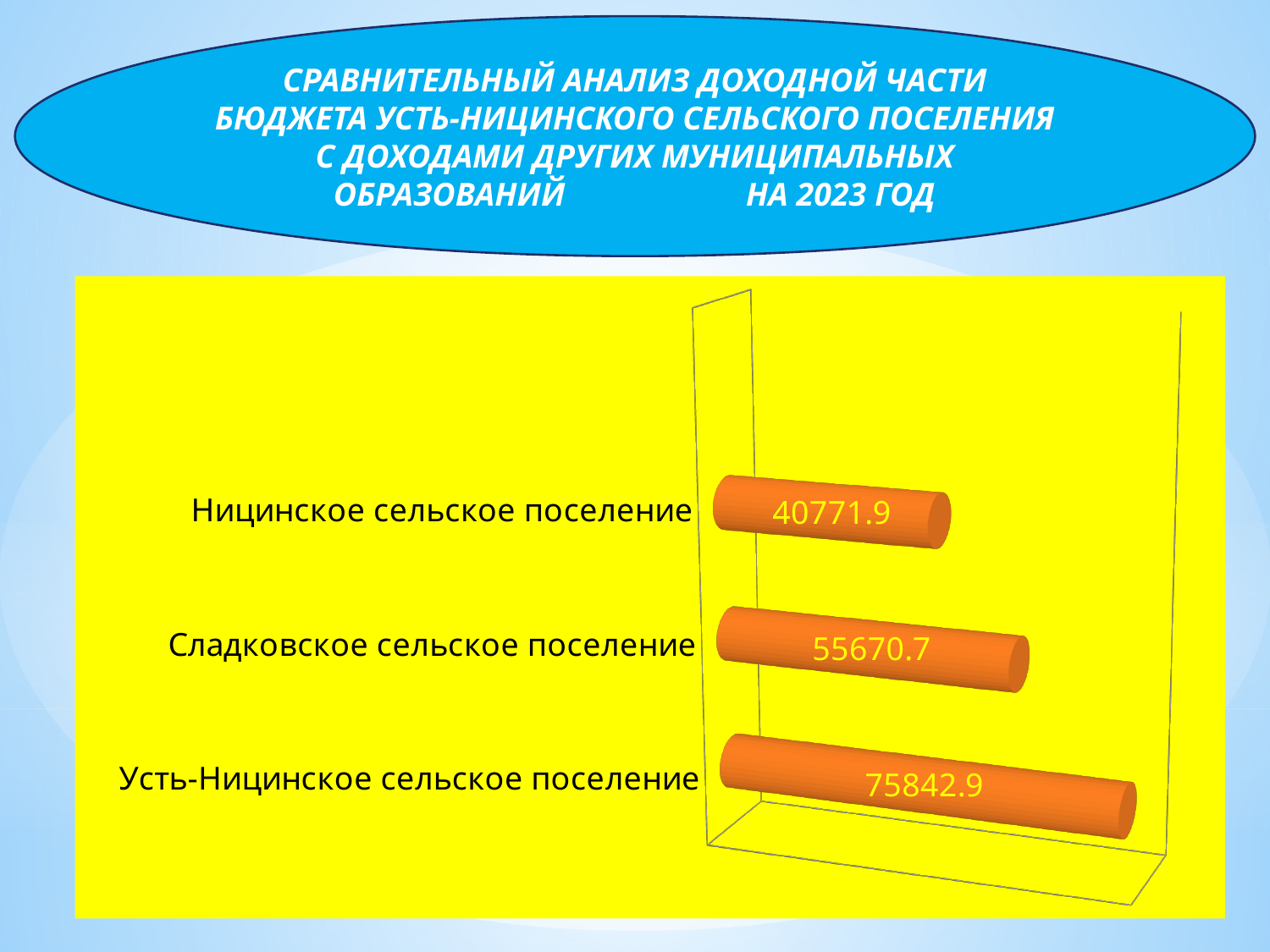
What is the difference between the values for Усть-Ницинское сельское поселение and Сладковское сельское поселение? 20172.2 What colour are the bars on the chart? Orange What is the value shown for Ницинское сельское поселение? 40771.9 What is the value shown for Сладковское сельское поселение? 55670.7 What is the value shown for Усть-Ницинское сельское поселение? 75842.9 What is the difference between the values for Усть-Ницинское сельское поселение and Ницинское сельское поселение? 35071.0 Which settlement has the lowest value on the chart? Ницинское сельское поселение Which settlement has the highest value on the chart? Усть-Ницинское сельское поселение What kind of chart is shown on the slide? Bar chart Which is larger, the value for Сладковское сельское поселение or the value for Ницинское сельское поселение? Сладковское сельское поселение How many settlements are shown on the chart? 3 What is the difference between the values for Сладковское сельское поселение and Ницинское сельское поселение? 14898.8